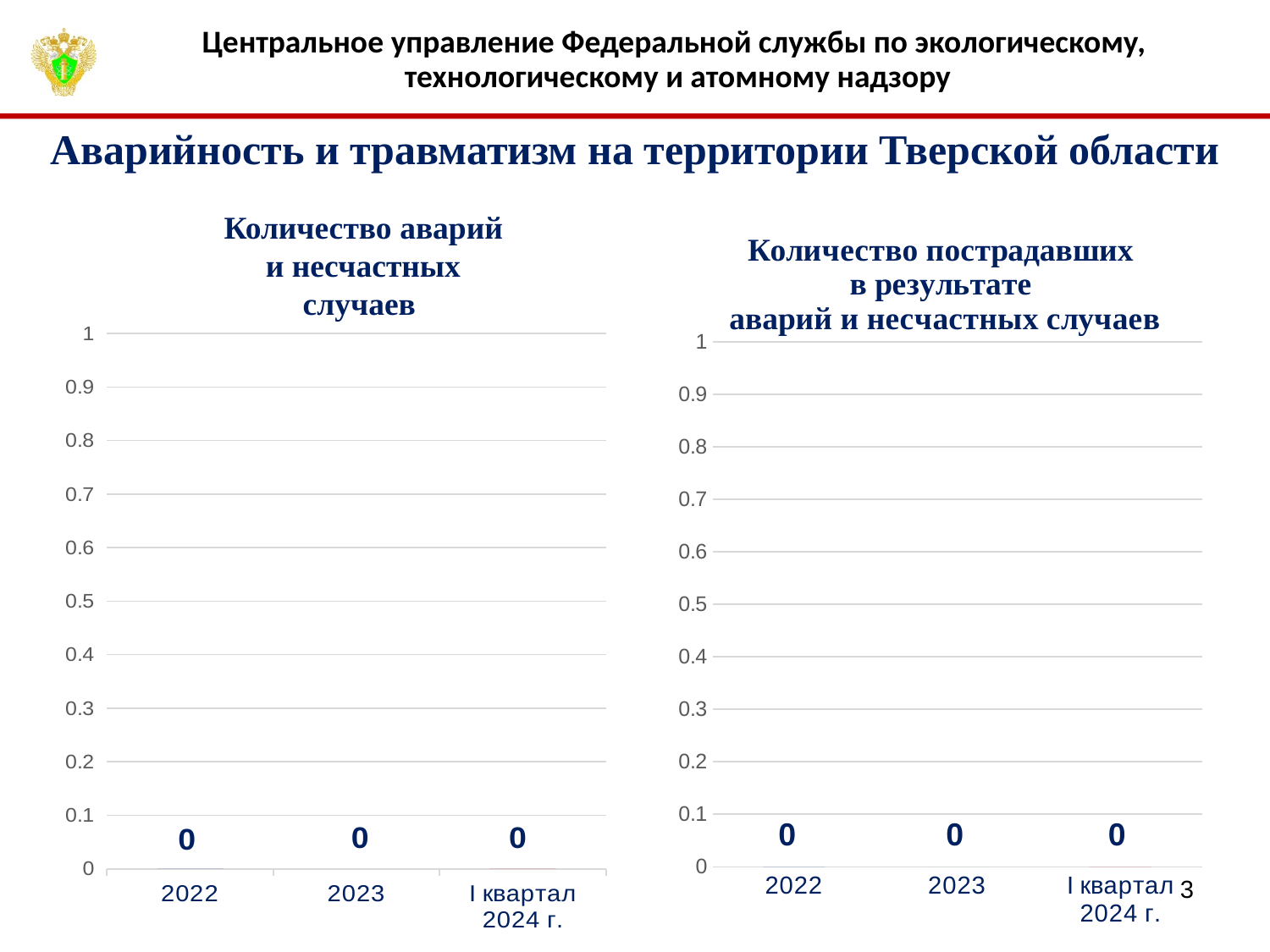
In the chart titled «Количество аварий и несчастных случаев», what is the value for 2022? 0 In the chart titled «Количество пострадавших в результате аварий и несчастных случаев», what is the value for 2022? 0 In the chart titled «Количество пострадавших в результате аварий и несчастных случаев», what is the value for 2023? 0 In the left chart, «Количество аварий и несчастных случаев», what is the difference between the values for 2023 and 2022? 0 In the chart titled «Количество аварий и несчастных случаев», what is the value for 2023? 0 In the left chart, «Количество аварий и несчастных случаев», do the values rise, fall, or stay the same from 2022 to «I квартал 2024 г.»? stay the same In the chart titled «Количество аварий и несчастных случаев», what is the value for «I квартал 2024 г.»? 0 How many categories are shown on the x axis of the right chart, «Количество пострадавших в результате аварий и несчастных случаев»? 3 In the chart titled «Количество пострадавших в результате аварий и несчастных случаев», what is the value for «I квартал 2024 г.»? 0 What is the maximum value shown on the vertical axis of the right chart, «Количество пострадавших в результате аварий и несчастных случаев»? 1 In the right chart, «Количество пострадавших в результате аварий и несчастных случаев», is the value for 2023 greater or less than 0.5? less How many categories are shown on the x axis of the left chart, «Количество аварий и несчастных случаев»? 3